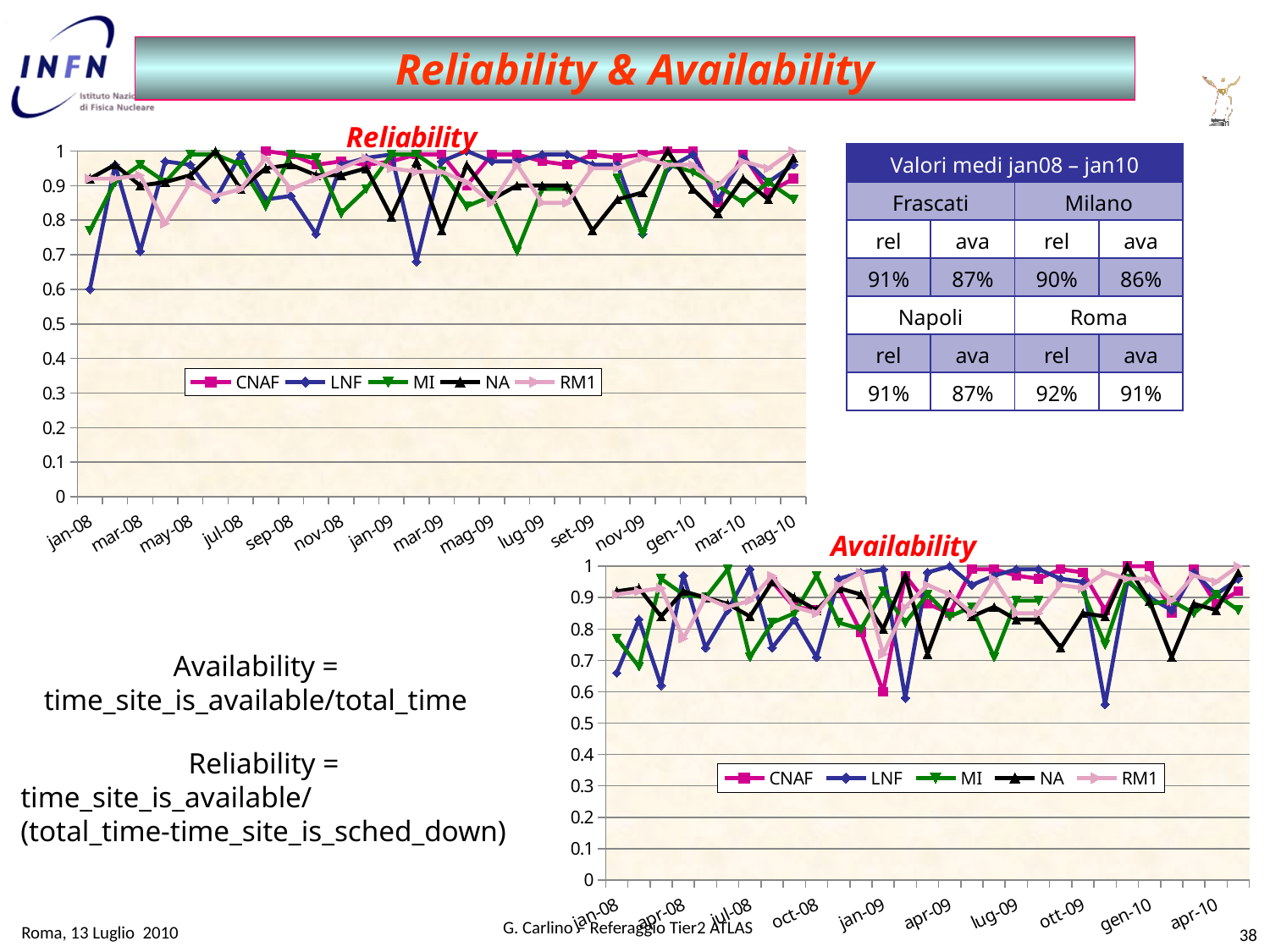
On the Reliability chart, which series is drawn in black? NA On the Reliability chart, is the value for LNF at jan-08 greater or less than 0.7? less What kind of chart is the Availability chart? line chart How many series does the legend of the Reliability chart list? 5 On the Availability chart, what is the highest value shown on the vertical axis? 1 On the Reliability chart, is the value for LNF at jan-08 greater or less than 0.5? greater On the Reliability chart, is the value for MI at jan-08 greater or less than 0.7? greater What kind of chart is the Reliability chart? line chart On the Reliability chart, which series reaches the lowest value over the whole period? LNF How many series does the legend of the Availability chart list? 5